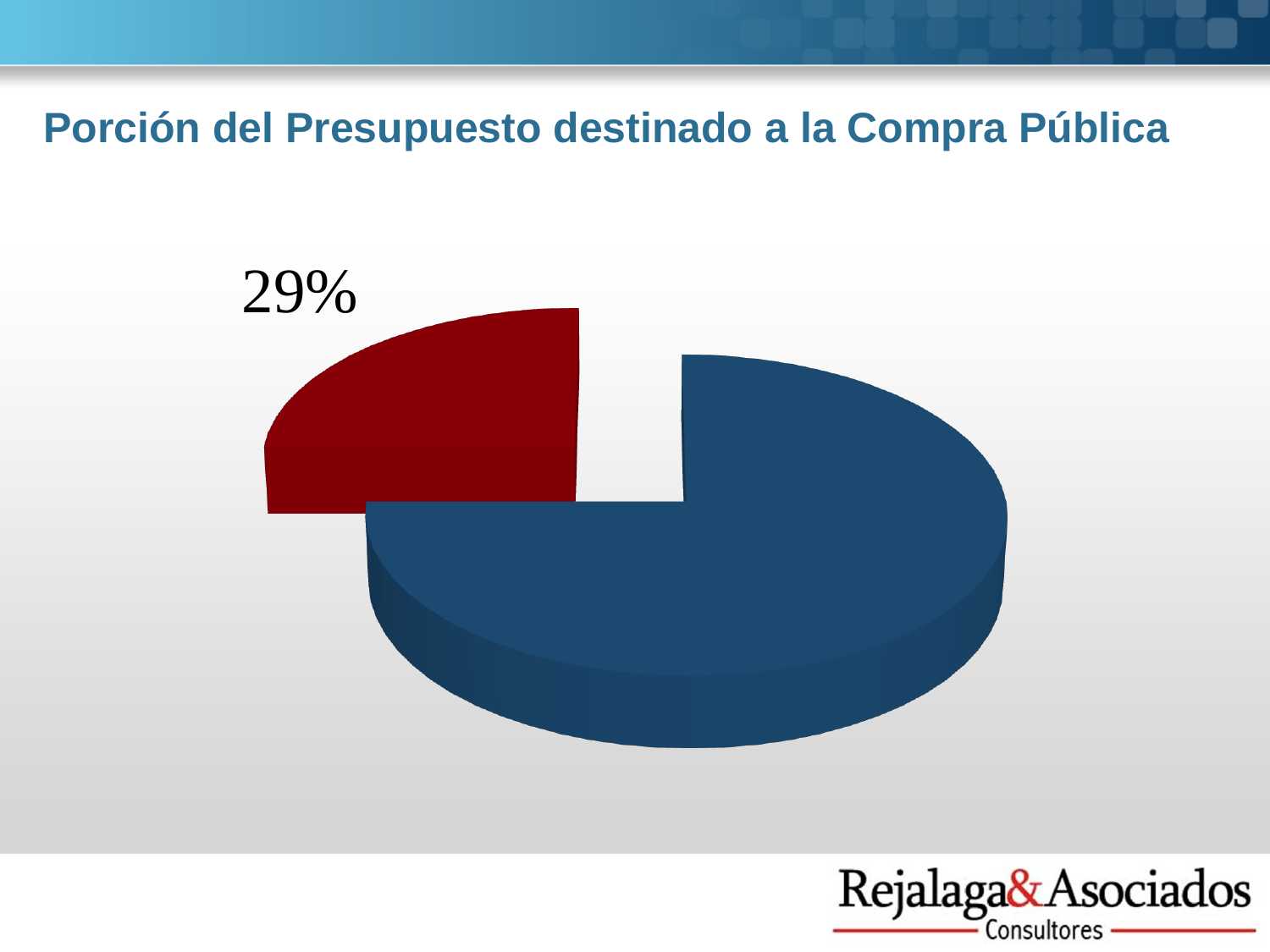
What kind of chart is shown on the slide? Pie chart How many slices does the pie chart have? 2 Which slice of the pie chart is larger, the red one or the blue one? The blue one What percentage is printed next to the red slice of the pie chart? 29% What is the title of the chart on the slide? Porción del Presupuesto destinado a la Compra Pública Which slice of the pie chart is pulled out (exploded) from the rest of the pie? The red slice What share of the pie does the red (exploded) slice represent? 29% Which slice of the pie chart is the smallest? The red slice (29%)